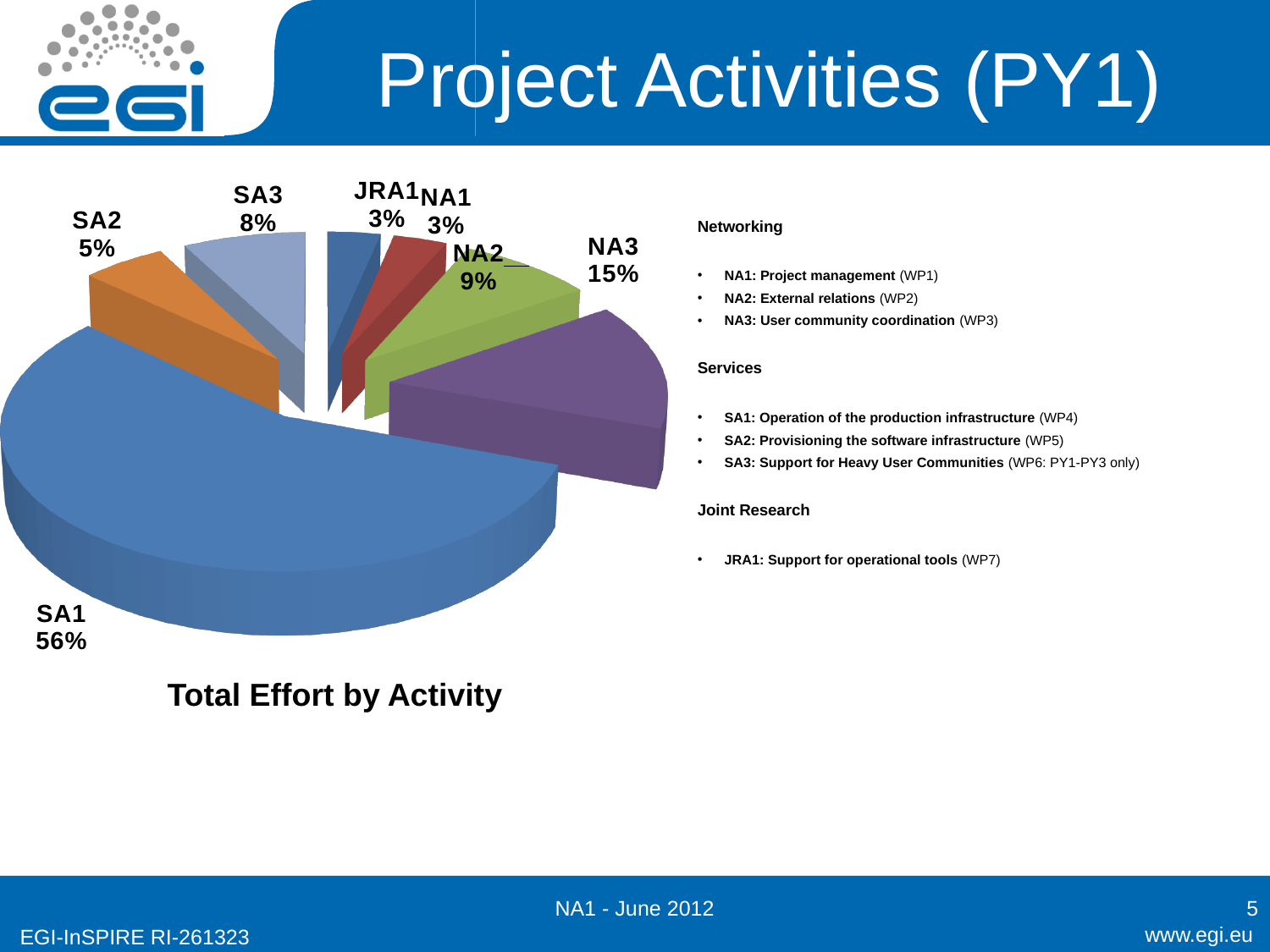
What percentage is shown for SA3 in the pie chart? 8% What percentage is shown for JRA1 in the pie chart? 3% Which has a larger share in the pie chart, SA2 or SA3? SA3 What is the title of the chart on the slide? Total Effort by Activity What kind of chart is used to show Total Effort by Activity? Pie chart What is the difference in percentage points between NA3 and NA2 in the pie chart? 6% Which activity has the largest share of total effort in the pie chart? SA1 What percentage is shown for NA3 in the pie chart? 15% What is the difference in percentage points between SA1 and NA3 in the pie chart? 41% What percentage is shown for NA2 in the pie chart? 9% How many activities (slices) are shown in the pie chart? 7 What share of total effort does SA1 account for in the pie chart? 56%